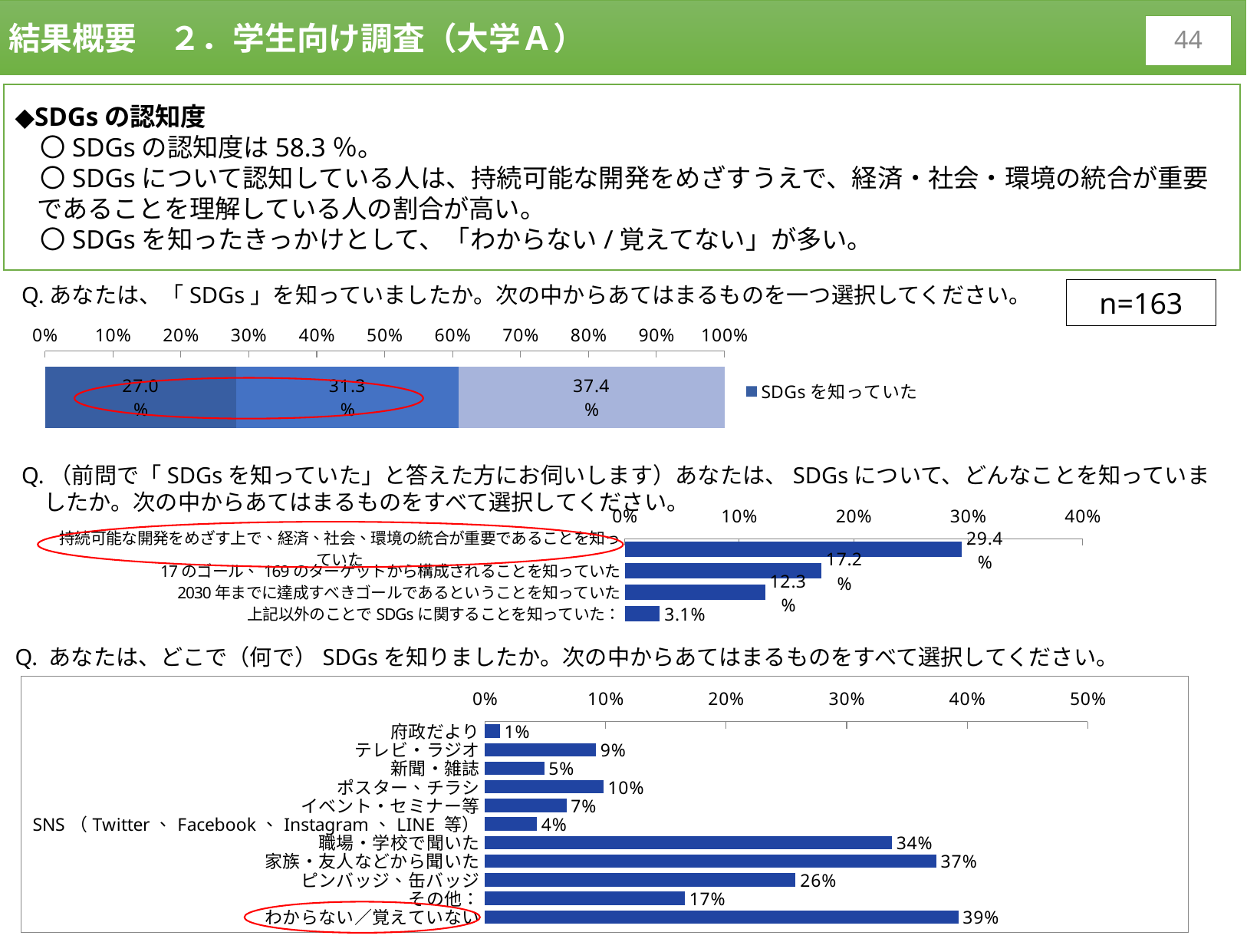
How many categories does the middle chart show? 4 In the bottom chart, what is the difference between 職場・学校で聞いた and ピンバッジ、缶バッジ? 8% In the middle chart, which category has the lowest value? 上記以外のことでSDGsに関することを知っていた How many categories does the bottom chart show? 11 What kind of chart is the bottom chart? bar chart In the middle chart (what respondents knew about SDGs), what is the value for 17のゴール、169のターゲットから構成されることを知っていた? 17.2% In the bottom chart (where respondents learned about SDGs), what is the value for 家族・友人などから聞いた? 37% In the bottom chart, what is the value for SNS（Twitter、Facebook、Instagram、LINE 等）? 4% In the bottom chart, which category has the highest value? わからない／覚えていない In the bottom chart, which is larger: テレビ・ラジオ or ポスター、チラシ? ポスター、チラシ In the top stacked bar chart, what is the value of the rightmost (lightest) segment? 37.4% In the bottom chart, which category has the lowest value? 府政だより